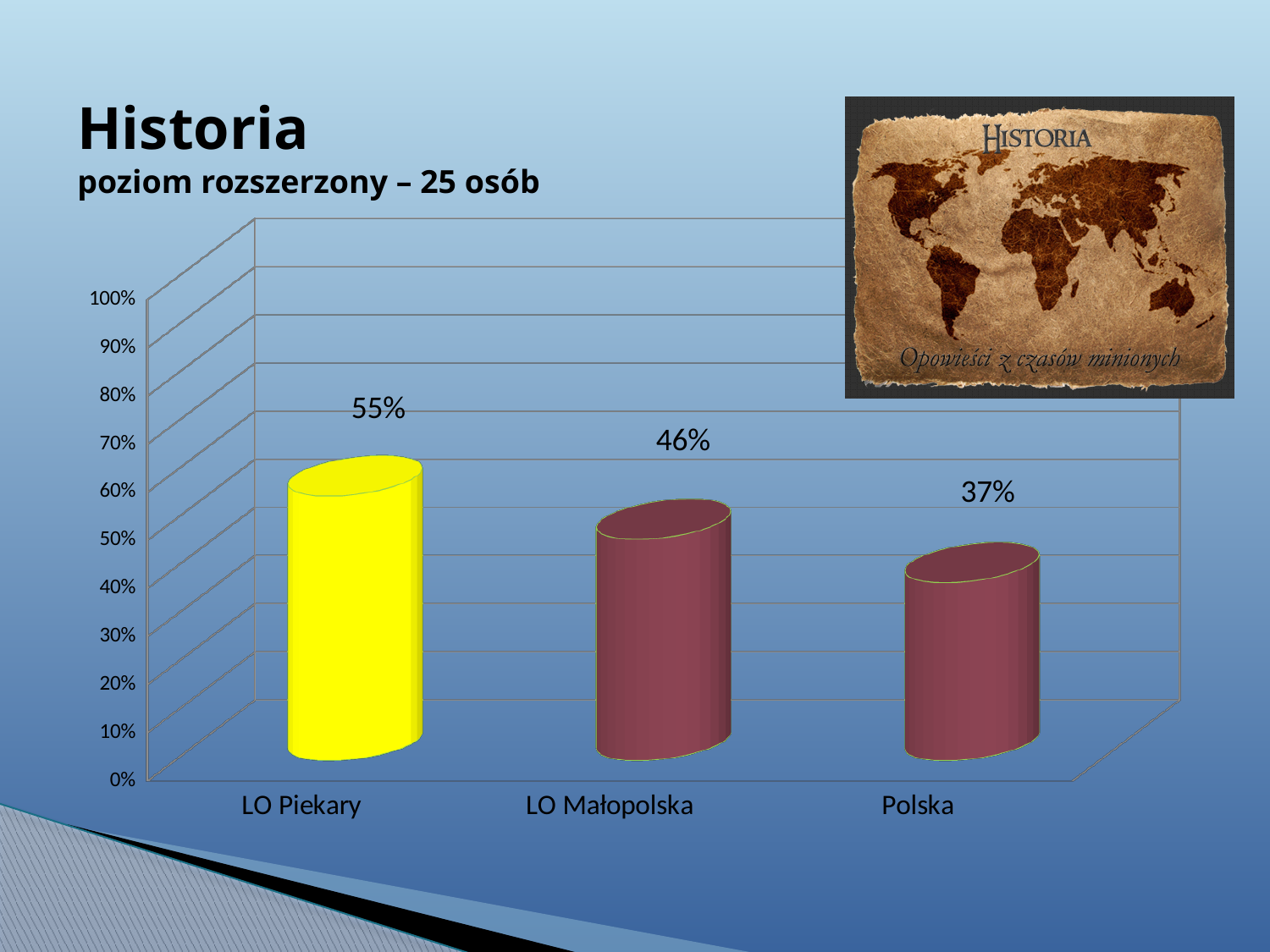
Is the value for LO Piekary greater or less than 50%? greater What is the value for LO Małopolska? 46% What is the difference between the values for LO Piekary and LO Małopolska? 9% What is the value for Polska? 37% Which category has the highest value? LO Piekary Which category has the lowest value? Polska Which is larger, the value for LO Małopolska or the value for Polska? LO Małopolska What is the difference between the values for LO Piekary and Polska? 18% What is the value for LO Piekary? 55% How many categories are shown in the chart? 3 Do the values rise or fall from left to right across the categories? fall What kind of chart is shown on the slide? bar chart